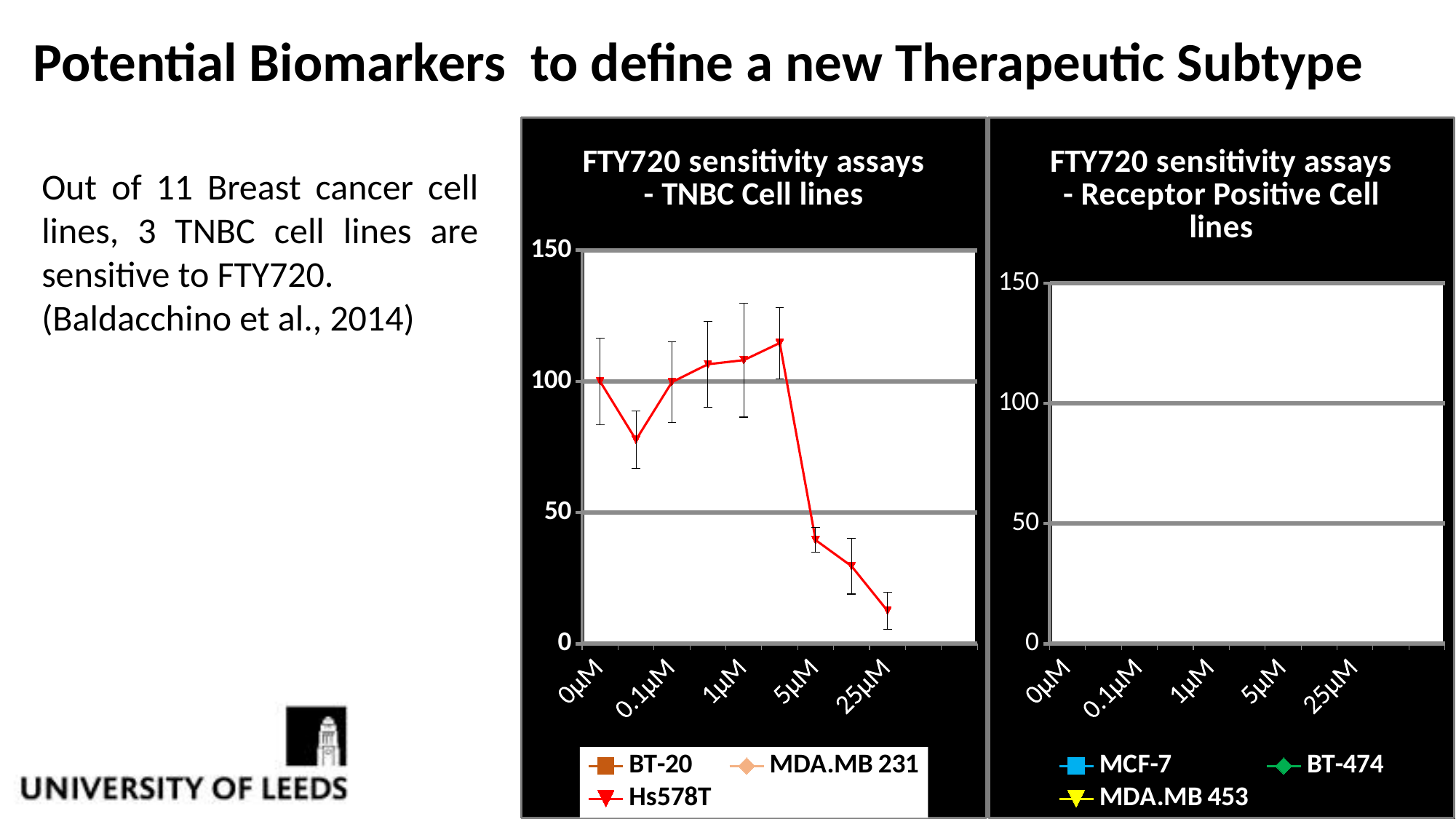
Which series is plotted in red with triangle markers in the 'FTY720 sensitivity assays - TNBC Cell lines' chart? Hs578T How many concentration labels are shown on the x axis of the 'FTY720 sensitivity assays - TNBC Cell lines' chart? 5 In the 'FTY720 sensitivity assays - TNBC Cell lines' chart, at which labelled concentration is the Hs578T value lowest? 25µM In the 'FTY720 sensitivity assays - TNBC Cell lines' chart, does the Hs578T line overall rise or fall from 0µM to 25µM? fall How many series does the legend of the 'FTY720 sensitivity assays - TNBC Cell lines' chart list? 3 How many series does the legend of the 'FTY720 sensitivity assays - Receptor Positive Cell lines' chart list? 3 In the 'FTY720 sensitivity assays - TNBC Cell lines' chart, is the Hs578T value at 5µM greater or less than 50? less In the 'FTY720 sensitivity assays - TNBC Cell lines' chart, is the Hs578T value at 1µM greater or less than 100? greater What kind of chart is the 'FTY720 sensitivity assays - TNBC Cell lines' chart? line chart In the 'FTY720 sensitivity assays - TNBC Cell lines' chart, is the Hs578T value at 25µM greater or less than 50? less In the 'FTY720 sensitivity assays - TNBC Cell lines' chart, which is larger for Hs578T: the value at 1µM or the value at 25µM? 1µM Which cell lines are listed in the legend of the 'FTY720 sensitivity assays - Receptor Positive Cell lines' chart? MCF-7, BT-474, MDA.MB 453